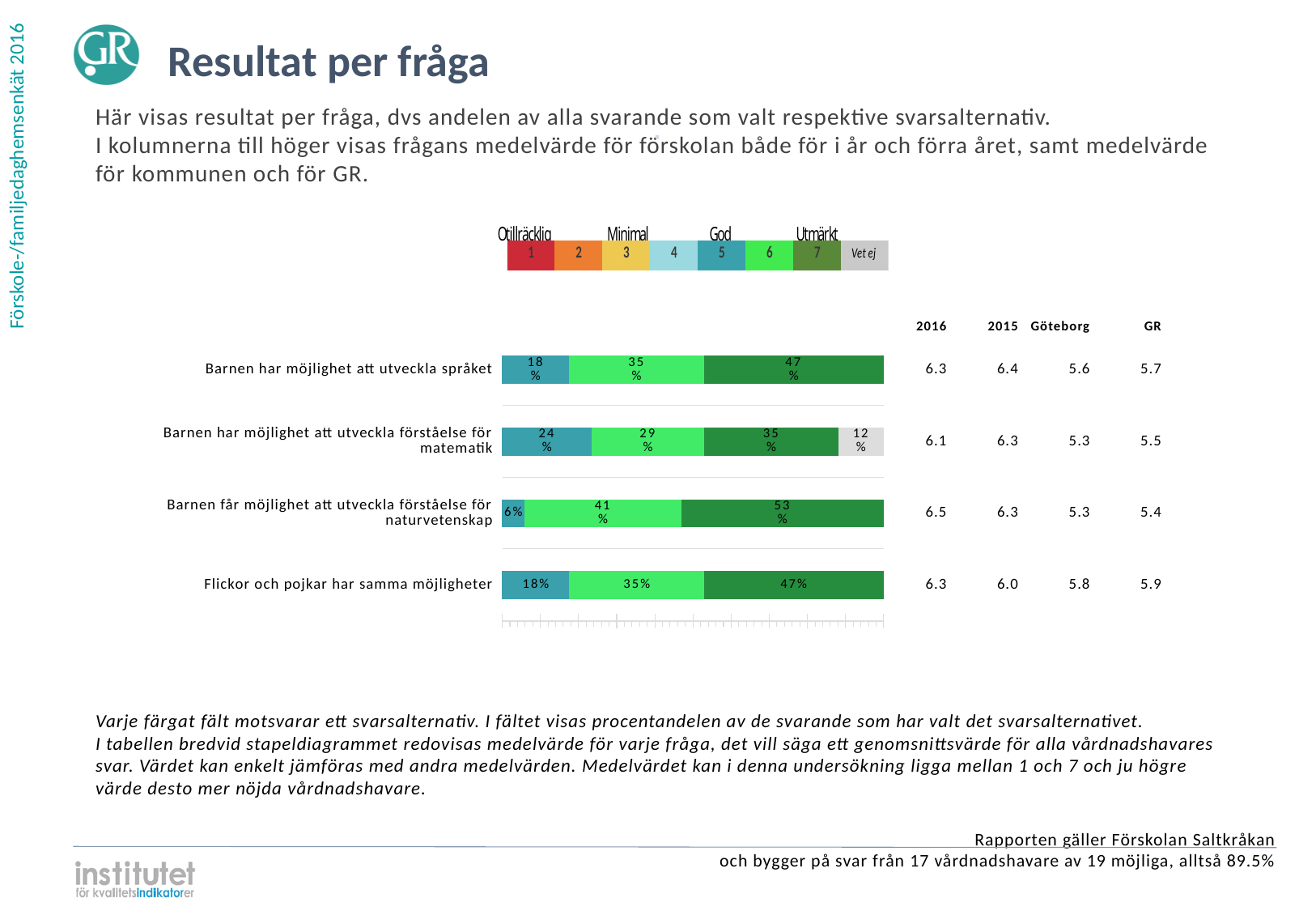
Which question has the lowest 2016 mean value? Barnen har möjlighet att utveckla förståelse för matematik How many questions (bars) are shown in the chart? 4 What is the Göteborg mean value for 'Flickor och pojkar har samma möjligheter'? 5.8 Which question has the highest 2016 mean value? Barnen får möjlighet att utveckla förståelse för naturvetenskap What is the difference between the 2016 and 2015 mean values for 'Flickor och pojkar har samma möjligheter'? 0.3 What percentage of respondents chose answer 7 (dark green) for 'Barnen får möjlighet att utveckla förståelse för naturvetenskap'? 53% Which is larger for 'Barnen har möjlighet att utveckla förståelse för matematik': the share choosing answer 6 (light green) or the share choosing answer 7 (dark green)? Answer 7 (35%) What is the 2016 mean value for 'Barnen får möjlighet att utveckla förståelse för naturvetenskap'? 6.5 What percentage chose answer 5 (teal) for 'Barnen har möjlighet att utveckla språket'? 18% What percentage chose 'Vet ej' for 'Barnen har möjlighet att utveckla förståelse för matematik'? 12% How many answer alternatives does the legend above the chart list, including 'Vet ej'? 8 What kind of chart is shown on the slide? Stacked bar chart